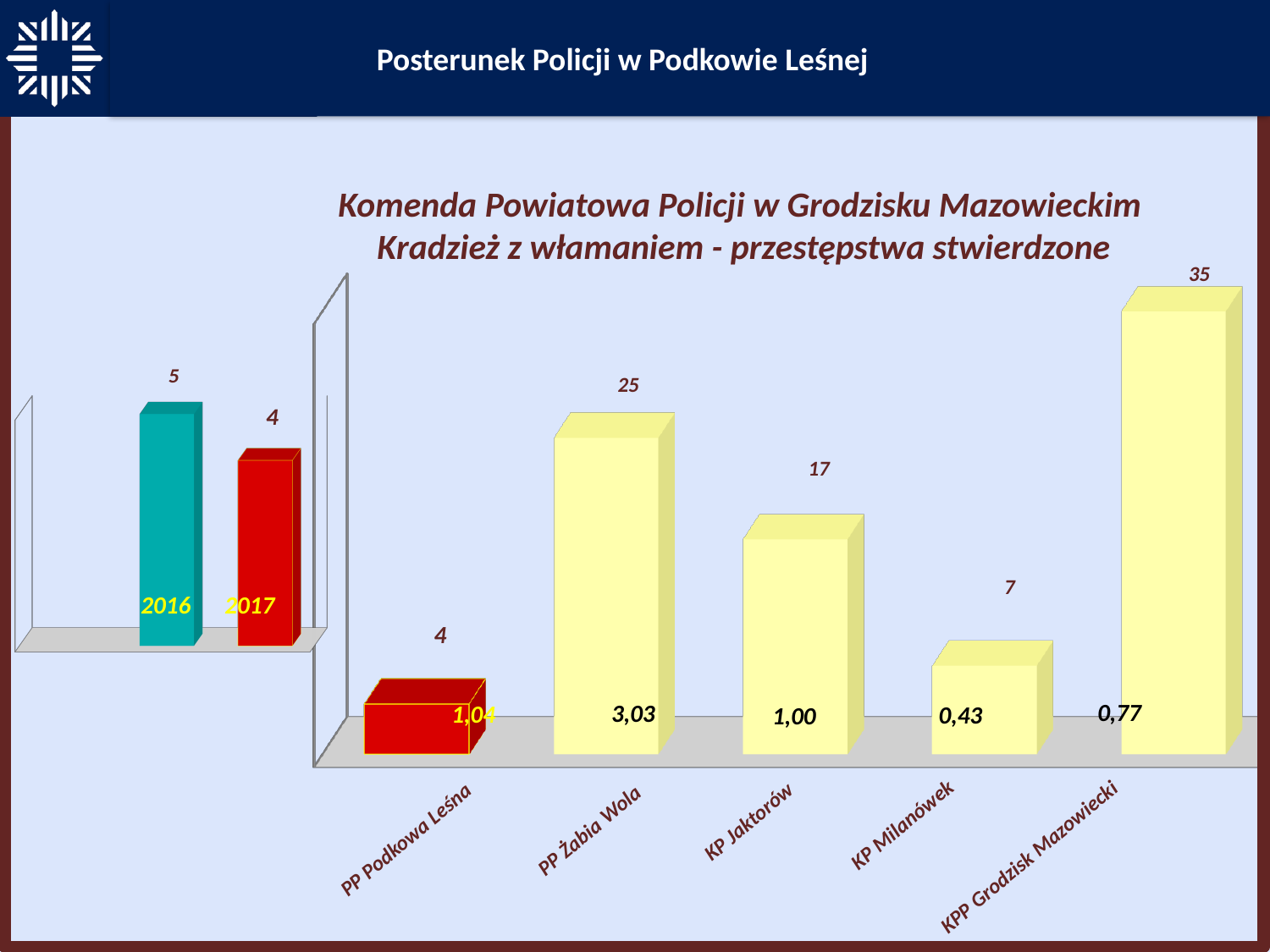
In the main chart on the right, what is the value for KPP Grodzisk Mazowiecki? 35 In the chart on the left, what is the difference between the 2016 and 2017 values? 1 What type of chart is the main chart on the right? bar chart In the main chart on the right, how many units (categories) are shown? 5 In the main chart on the right, which unit has the highest value? KPP Grodzisk Mazowiecki In the chart on the left, which year has the higher value, 2016 or 2017? 2016 In the chart on the left, what is the value for 2017? 4 In the main chart on the right, which unit has the lowest value? PP Podkowa Leśna In the main chart on the right, what is the value for KP Jaktorów? 17 In the main chart on the right, what is the difference between the values for PP Żabia Wola and KP Milanówek? 18 In the chart on the left, what is the value for 2016? 5 In the main chart on the right, what is the smaller label printed at the base of the bar for PP Żabia Wola? 3,03